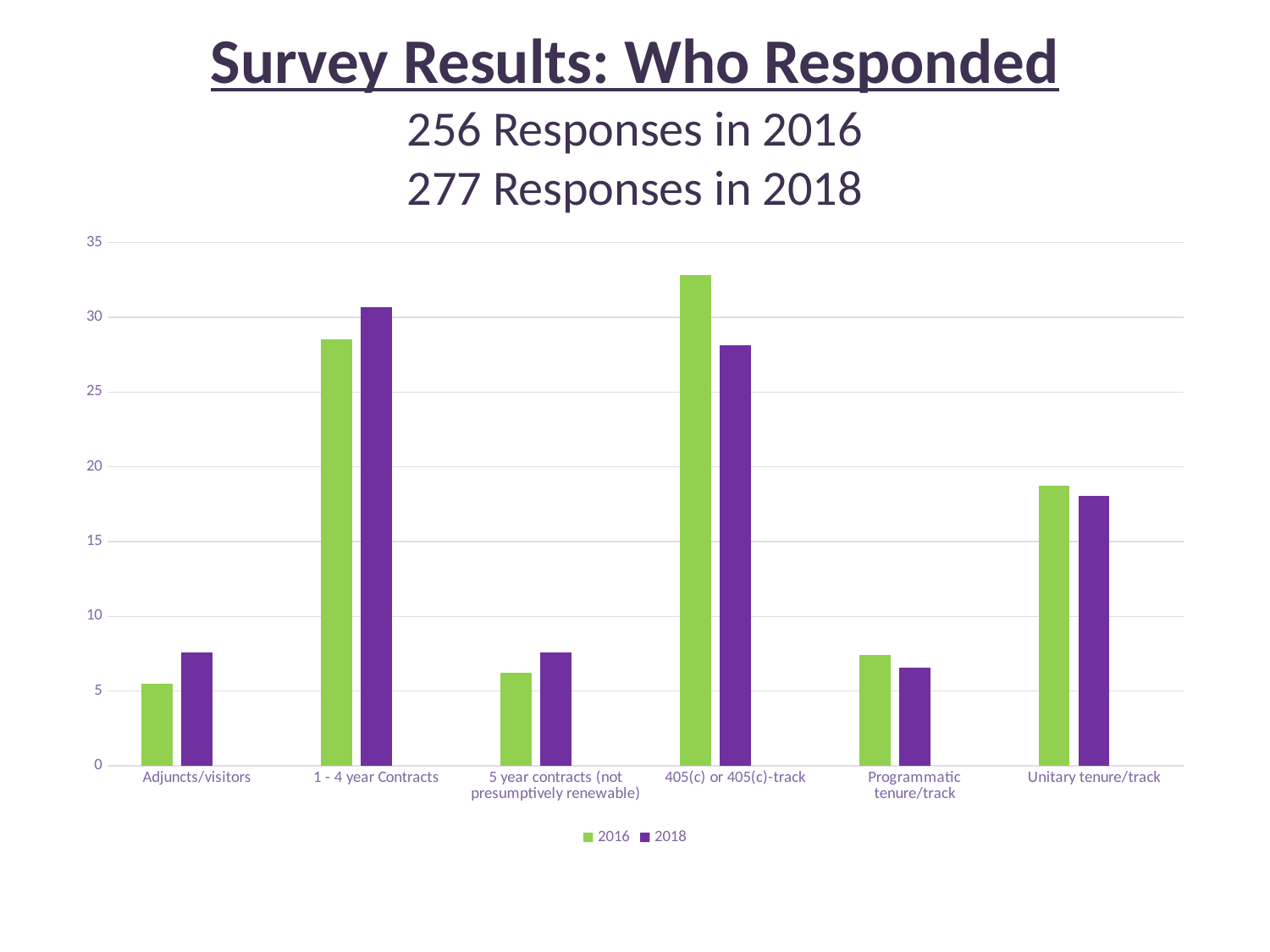
Which colour represents the 2018 series in the chart? purple How many series does the legend list? 2 Which category has the highest value for the 2018 series? 1 - 4 year Contracts For 1 - 4 year Contracts, which series has the larger value, 2016 or 2018? 2018 Is the 2016 value for Unitary tenure/track greater or less than 20? less Is the 2018 value for Programmatic tenure/track greater or less than 10? less How many categories are shown on the x axis of the chart? 6 What kind of chart is shown on the slide? bar chart For 405(c) or 405(c)-track, which series has the larger value, 2016 or 2018? 2016 For Adjuncts/visitors, which series has the larger value, 2016 or 2018? 2018 Is the 2016 value for 405(c) or 405(c)-track greater or less than 30? greater Which category has the highest value for the 2016 series? 405(c) or 405(c)-track